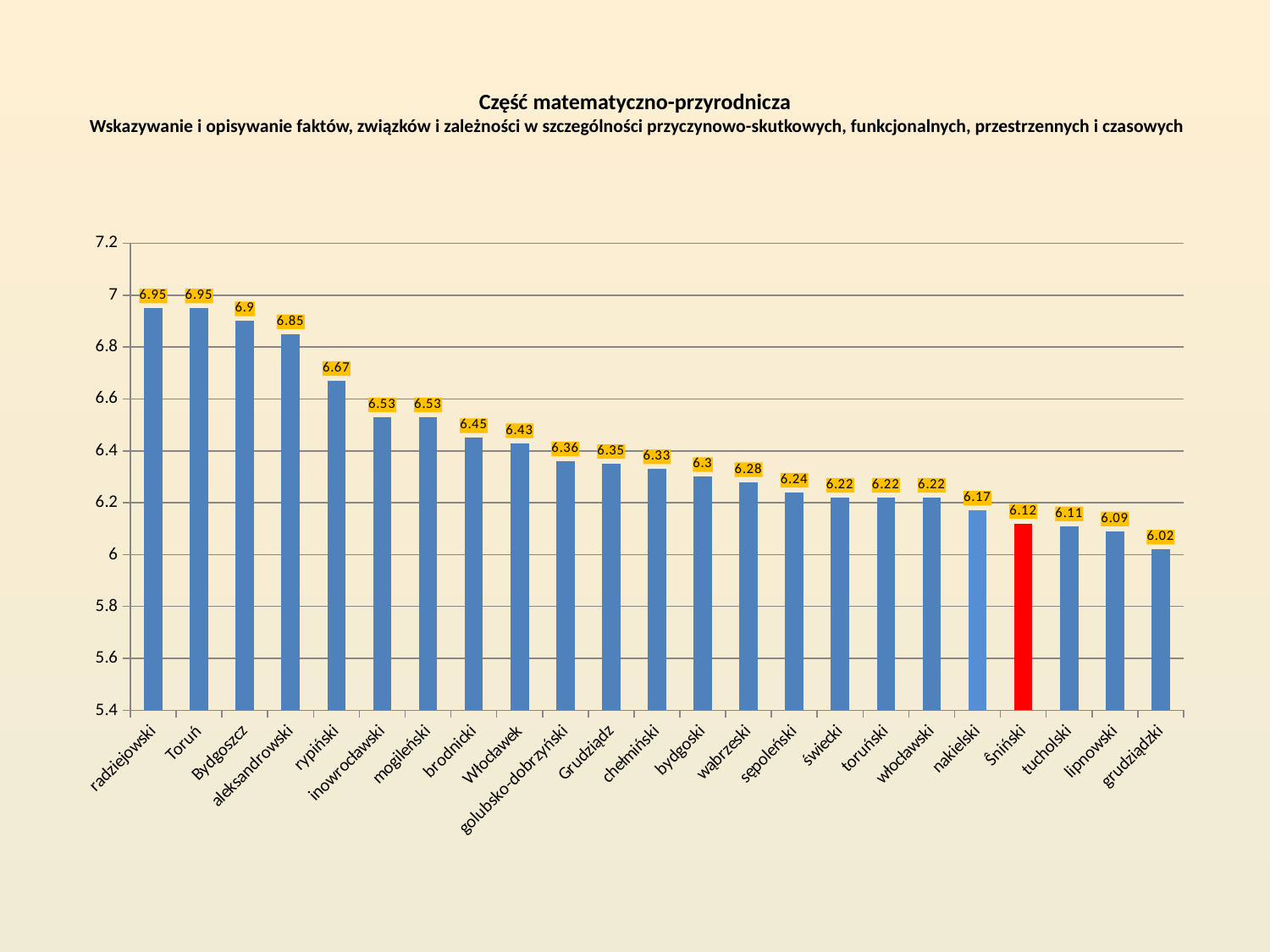
What is the difference between the values for aleksandrowski and grudziądzki? 0.83 What is the value for rypiński? 6.67 What is the value for the red bar, żniński? 6.12 Which category has the lowest value? grudziądzki What kind of chart is shown on the slide? bar chart Is the value for sępoleński greater or less than 6.4? less What is the value for Bydgoszcz? 6.9 Which is larger, the value for Grudziądz or the value for bydgoski? Grudziądz What is the difference between the values for brodnicki and Włocławek? 0.02 Do the values rise or fall from left to right along the x axis? fall How many categories are shown on the x axis? 23 What is the value for nakielski? 6.17